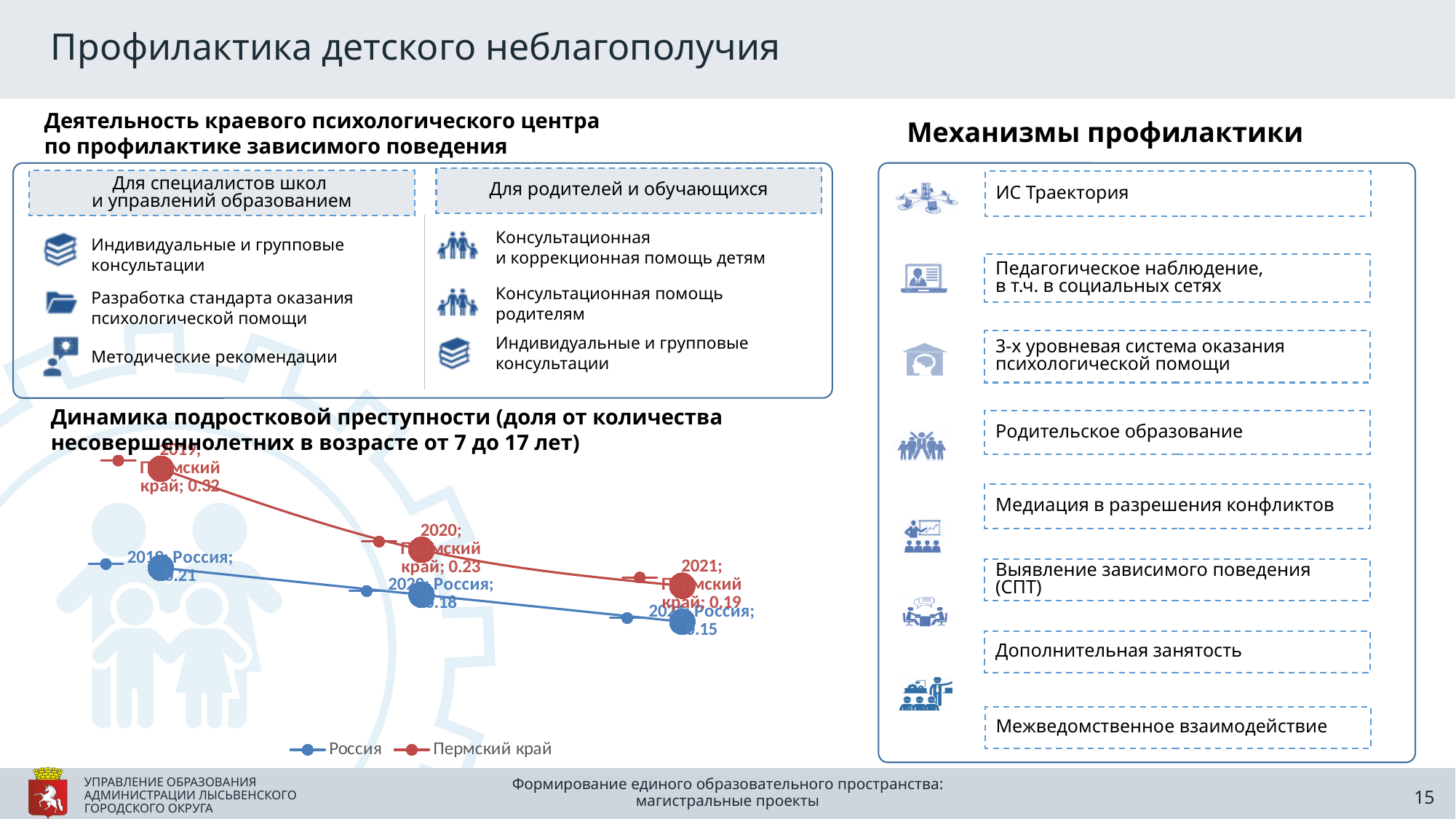
In the teenage crime chart, what is the value for Пермский край in 2020? 0.23 How many series does the legend of the teenage crime chart list? 2 In the teenage crime chart, do the values for Пермский край rise or fall from 2019 to 2021? fall In the teenage crime chart, what is the value for Россия in 2019? 0.21 In the teenage crime chart, which year has the highest value for Пермский край? 2019 In the teenage crime chart, what is the difference between Пермский край and Россия in 2020? 0.05 In the teenage crime chart, what is the value for Пермский край in 2021? 0.19 In the teenage crime chart, what is the value for Россия in 2021? 0.15 In the teenage crime chart, which series has the larger value in 2021, Россия or Пермский край? Пермский край What are the two series named in the legend of the teenage crime chart? Россия and Пермский край In the teenage crime chart, which year has the lowest value for Россия? 2021 What type of chart is used to show the dynamics of teenage crime (Динамика подростковой преступности)? line chart